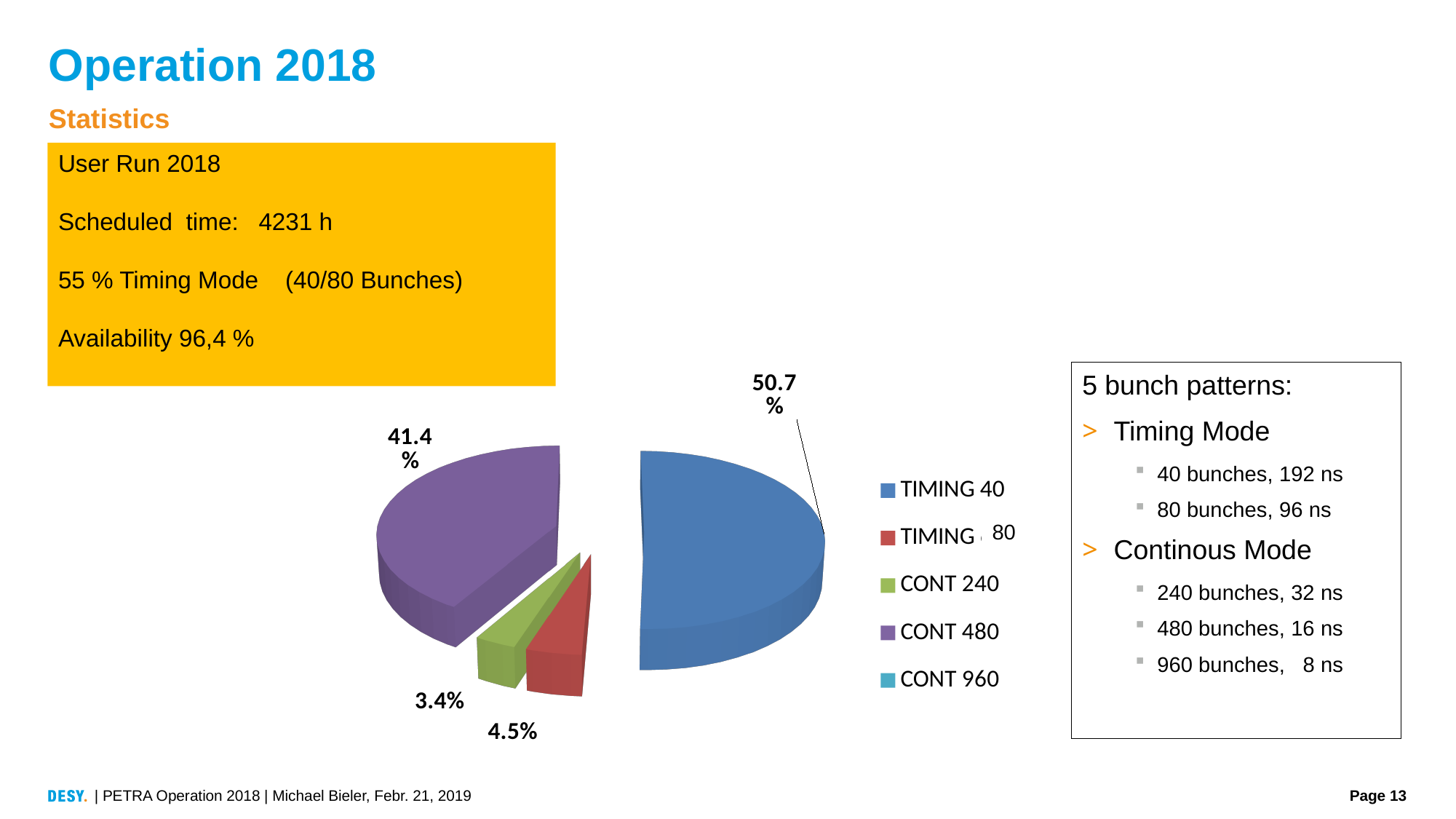
Which legend entry has the largest slice of the pie? TIMING 40 What percentage of the pie is labelled for TIMING 40? 50.7% Which slice is larger, TIMING 80 or CONT 240? TIMING 80 Which slice is larger, CONT 480 or TIMING 40? TIMING 40 Which legend entry is shown in blue in the pie chart? TIMING 40 What is the difference in percentage points between the TIMING 40 slice and the CONT 480 slice? 9.3 What percentage of the pie is labelled for CONT 480? 41.4% What colour is the CONT 480 slice in the pie chart? purple What percentage of the pie is labelled for TIMING 80? 4.5% How many entries does the legend of the pie chart list? 5 What percentage of the pie is labelled for CONT 240? 3.4% What kind of chart is shown on the slide? pie chart